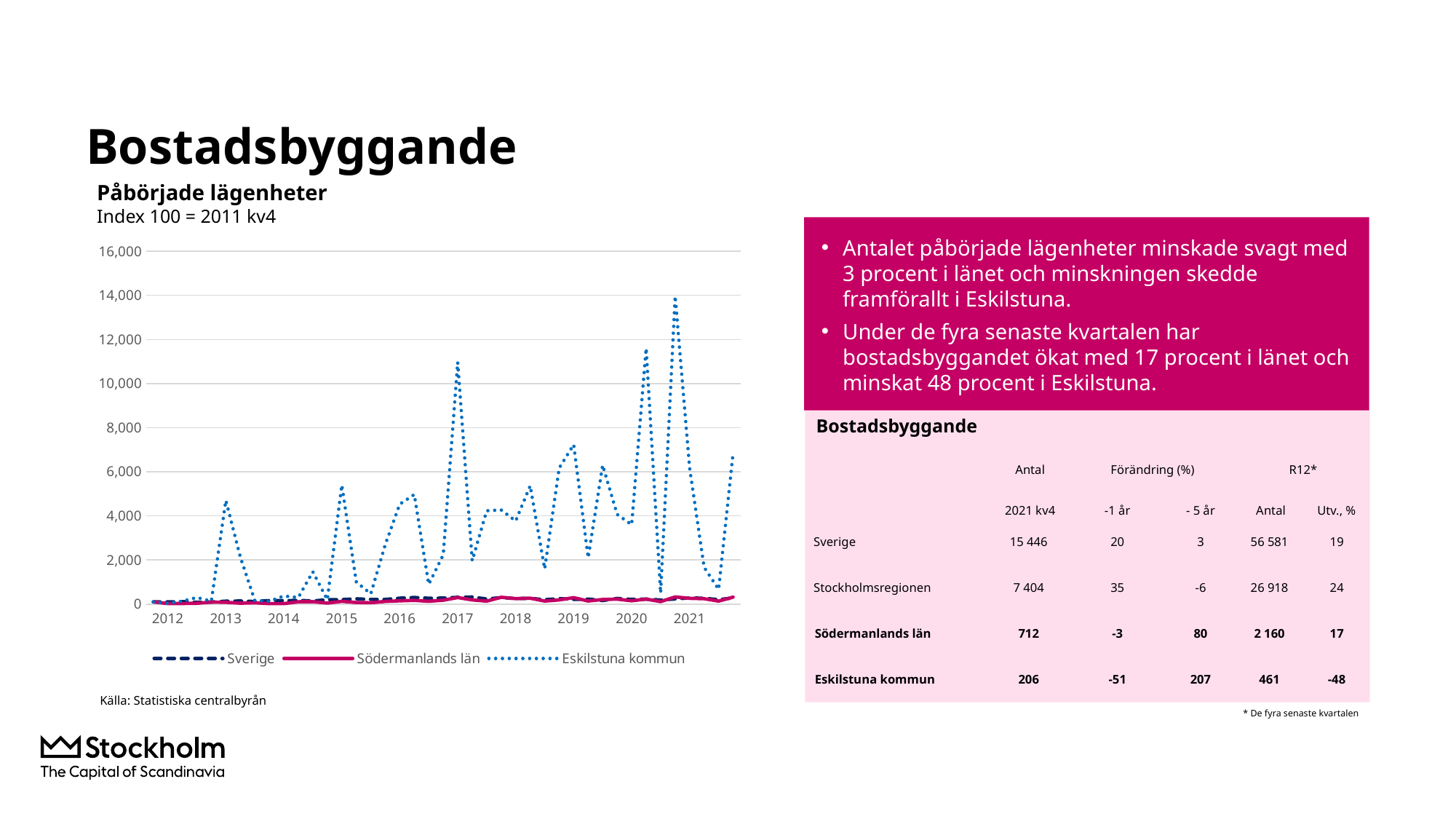
Which series reaches the highest value in the chart? Eskilstuna kommun How many series does the legend of the chart list? 3 Is the peak of the Eskilstuna kommun line in 2013 greater or less than 6,000? less Is the Sverige line ever greater or less than 2,000 across the whole chart? less Which series is higher in 2020, Eskilstuna kommun or Sverige? Eskilstuna kommun Which series are listed in the chart's legend? Sverige, Södermanlands län, Eskilstuna kommun What is the title of the chart? Påbörjade lägenheter What is the highest value shown on the y axis of the chart? 16,000 Is the peak of the Eskilstuna kommun line in 2017 greater or less than 10,000? greater How many year labels are shown on the x axis of the chart? 10 What kind of chart is shown on the slide? Line chart